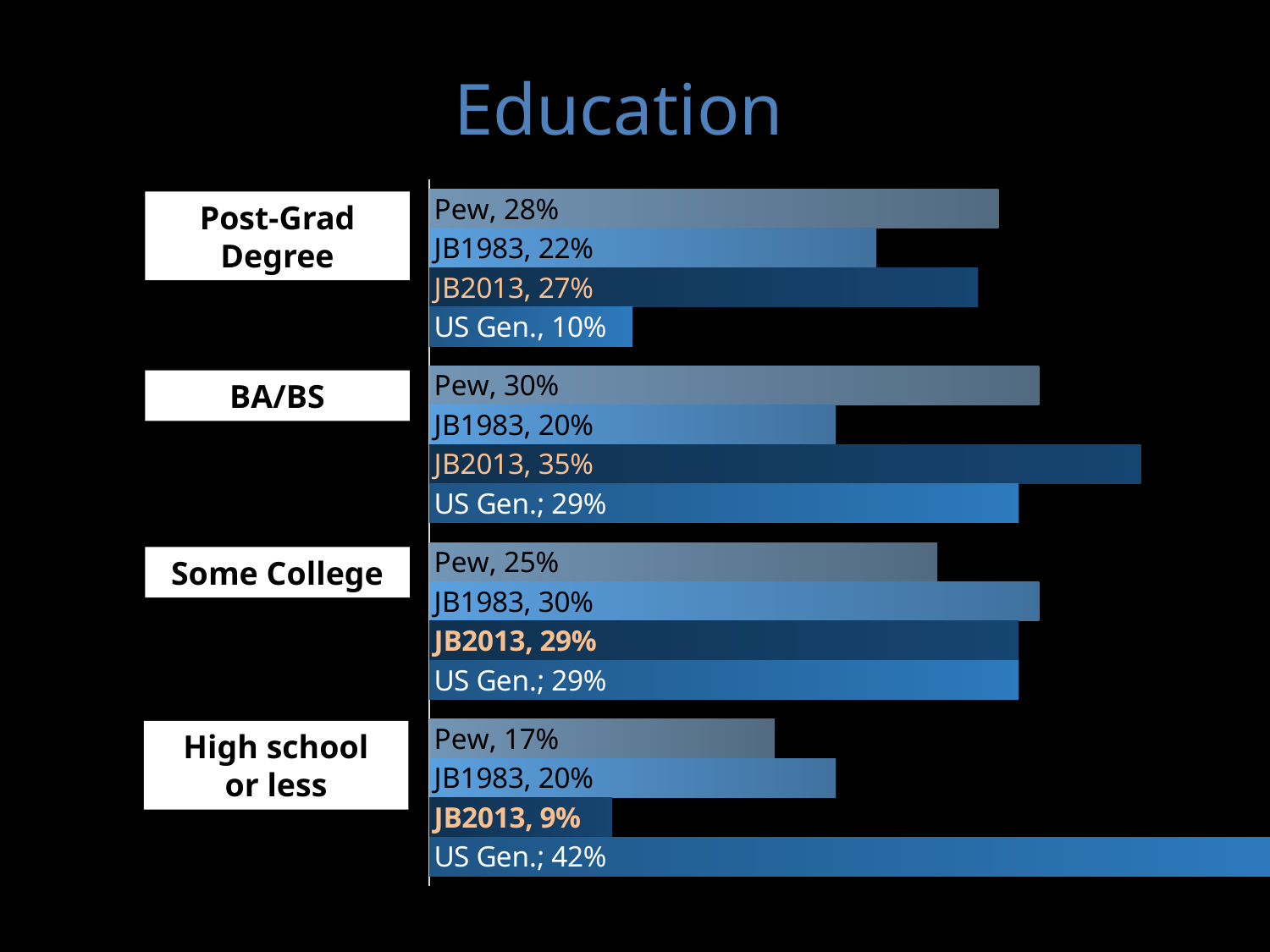
What is the title of the chart? Education How many education categories are shown on the chart? 4 What is the value for JB2013 in the BA/BS category? 35% Which series has the lowest value in the Post-Grad Degree category? US Gen. Which is larger in the Post-Grad Degree category: Pew or JB2013? Pew What kind of chart is shown on the slide? Bar chart What is the difference between the JB2013 and JB1983 values in the BA/BS category? 15% Which series has the highest value in the High school or less category? US Gen. What is the value for Pew in the Post-Grad Degree category? 28% What is the value for US Gen. in the High school or less category? 42% How many series are shown for each education category? 4 What is the value for JB1983 in the Some College category? 30%